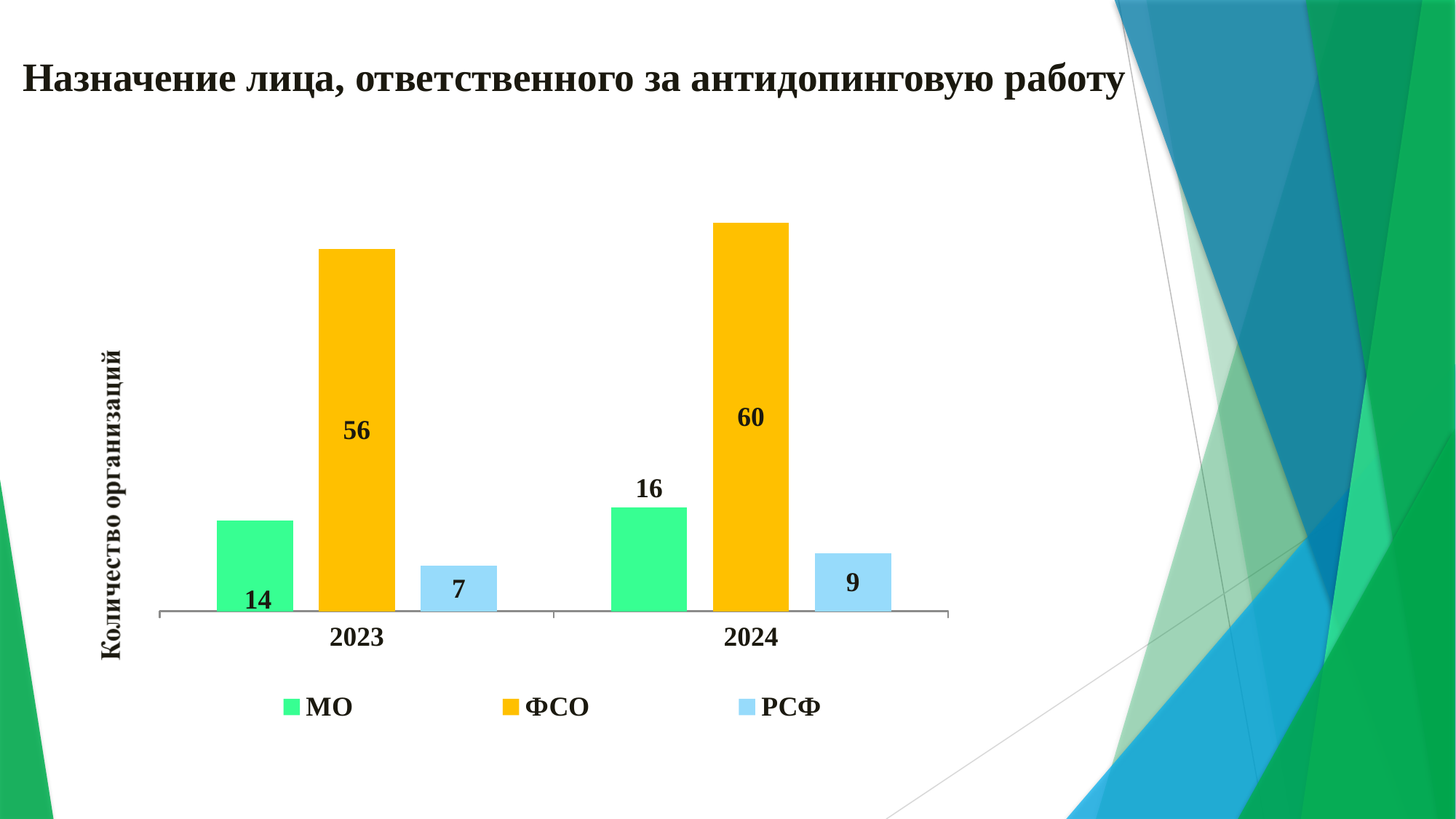
Does the РСФ value rise or fall from 2023 to 2024? rise What is the difference between the ФСО values for 2024 and 2023? 4 What is the value for ФСО in 2023? 56 Which series has the lowest value in 2023? РСФ How many categories are shown on the x axis? 2 What is the value for РСФ in 2023? 7 How many series does the legend list? 3 What is the difference between the МО and РСФ values in 2024? 7 Which is larger, the МО value in 2023 or the МО value in 2024? 2024 Which series has the highest value in 2024? ФСО What is the value for МО in 2024? 16 What kind of chart is shown on the slide? bar chart